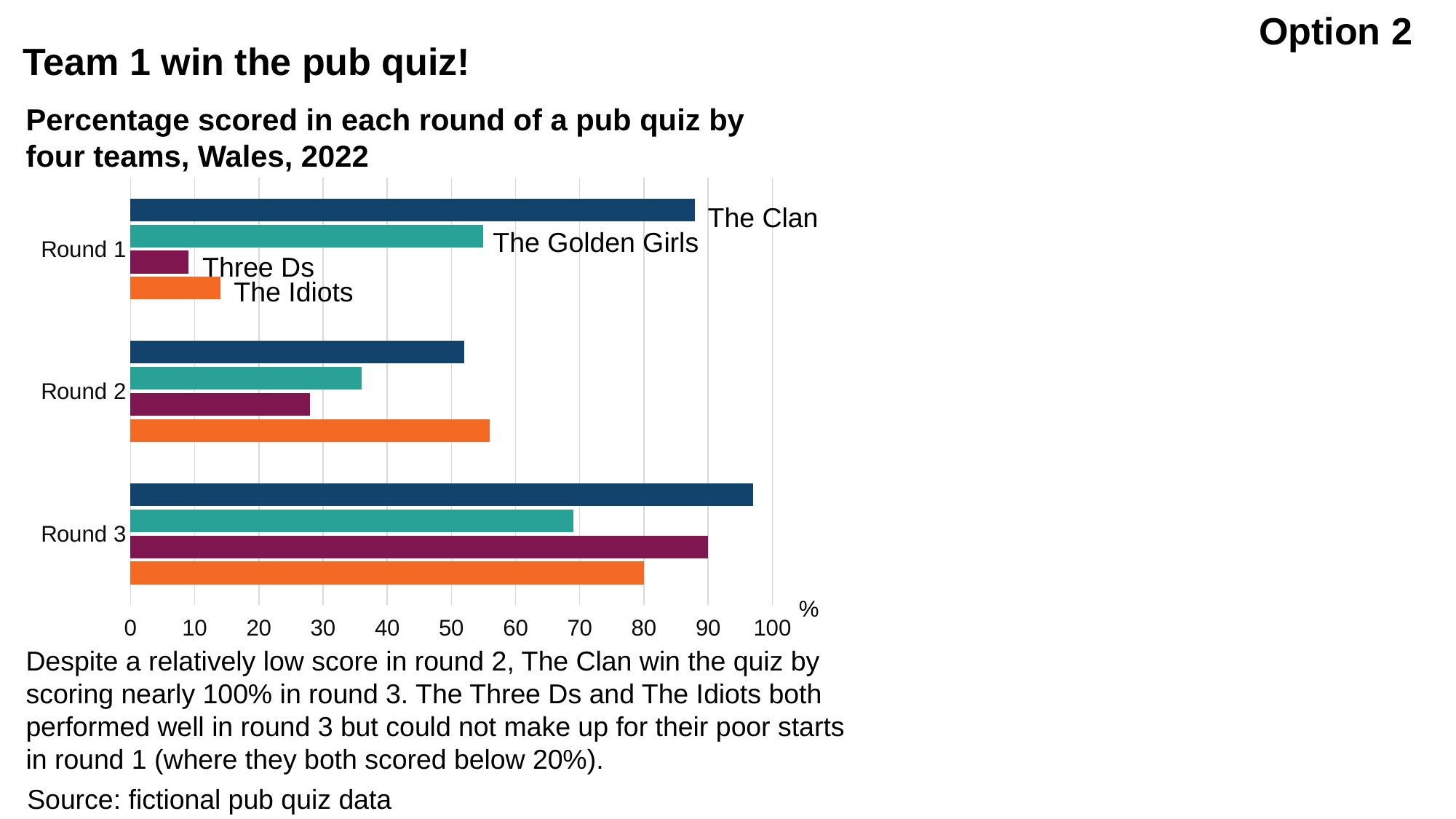
How many rounds are shown on the chart's vertical axis? 3 How many teams are plotted in the chart? 4 Do the Three Ds' scores rise or fall from Round 1 through Round 3? rise Which team scored the highest percentage in Round 3? The Clan Which team scored the lowest percentage in Round 2? Three Ds Is the Three Ds' Round 1 score greater or less than 20%? less Which team scored the highest percentage in Round 1? The Clan Which team scored the lowest percentage in Round 1? Three Ds What is the source given for the chart's data? fictional pub quiz data In Round 3, which team scored higher: The Golden Girls or The Idiots? The Idiots What kind of chart is shown on the slide? bar chart Is The Clan's Round 1 score greater or less than 80%? greater